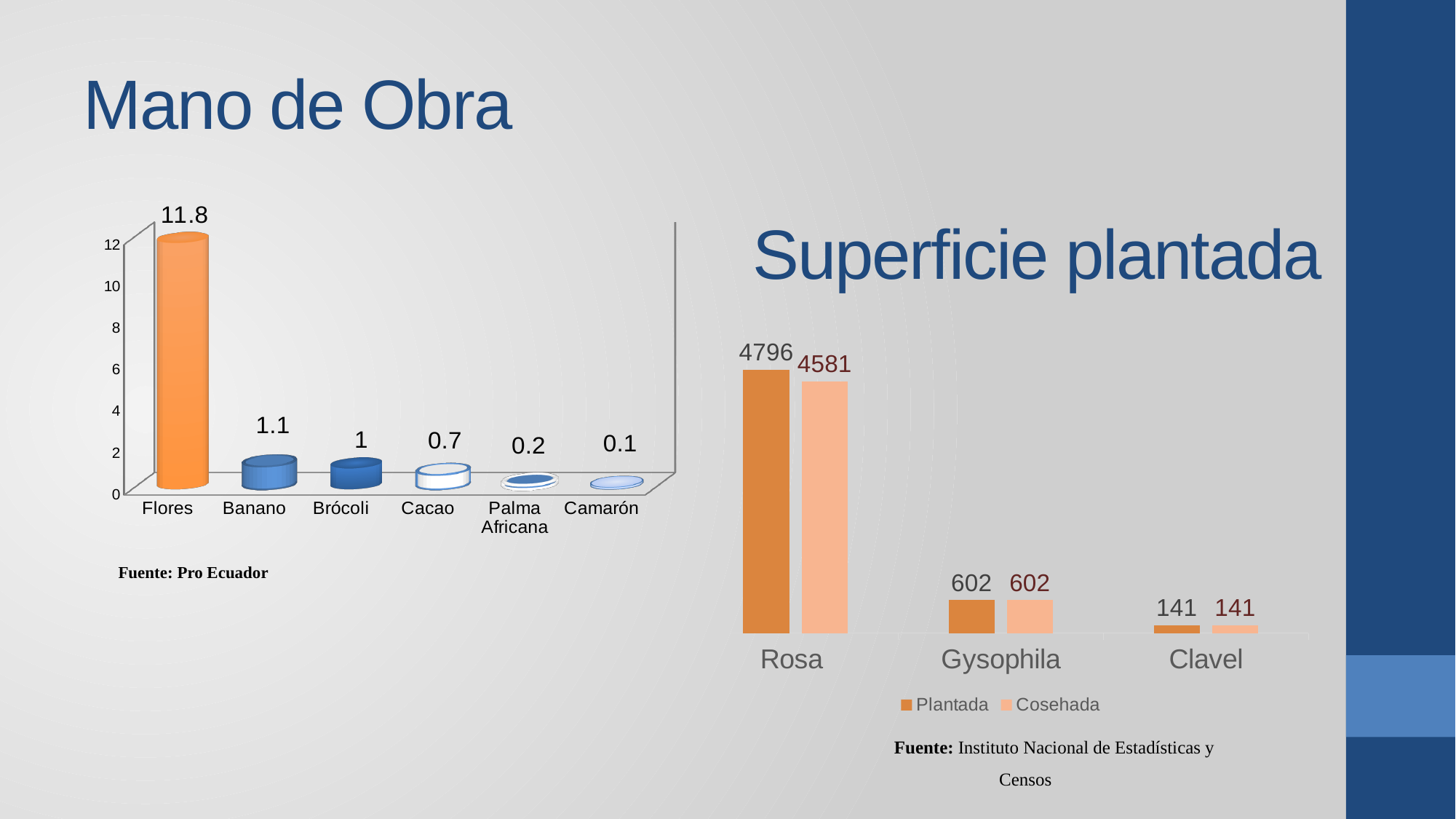
In the Mano de Obra chart on the left, how many categories are shown? 6 In the Mano de Obra chart on the left, what is the value for Cacao? 0.7 In the Mano de Obra chart on the left, which category has the highest value? Flores In the Superficie plantada chart on the right, how many series does the legend list? 2 In the Mano de Obra chart on the left, what is the difference between the values for Flores and Banano? 10.7 What kind of chart is the Superficie plantada chart on the right? bar chart In the Superficie plantada chart on the right, what is the difference between the Plantada and Cosehada values for Rosa? 215 In the Mano de Obra chart on the left, which category has the lowest value? Camarón In the Superficie plantada chart on the right, what is the Cosehada value for Gysophila? 602 In the Superficie plantada chart on the right, what is the Plantada value for Rosa? 4796 In the Mano de Obra chart on the left, do the values rise or fall from Flores to Camarón? fall In the Mano de Obra chart on the left, what is the value for Flores? 11.8